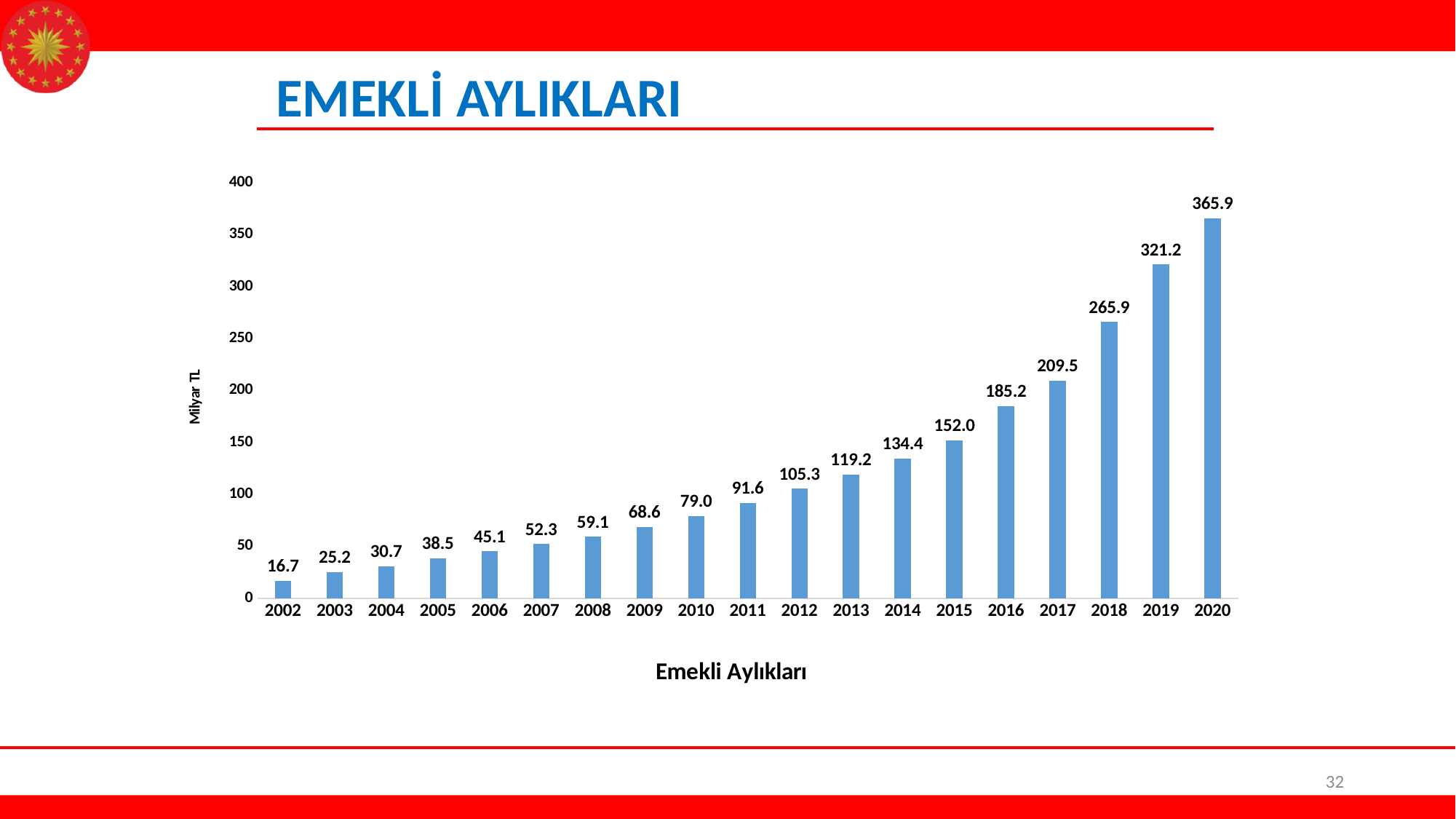
What is the difference between the values for 2015 and 2014? 17.6 Do the values rise or fall from 2002 to 2020? rise Which year has the highest value? 2020 What is the difference between the values for 2020 and 2019? 44.7 How many years are shown on the x axis? 19 What is the value for 2018? 265.9 Is the value for 2017 greater or less than 200? greater What is the value for 2010? 79.0 Which is larger, the value for 2013 or the value for 2016? 2016 Which year has the lowest value? 2002 What is the value for 2002? 16.7 What kind of chart is shown on the slide? bar chart